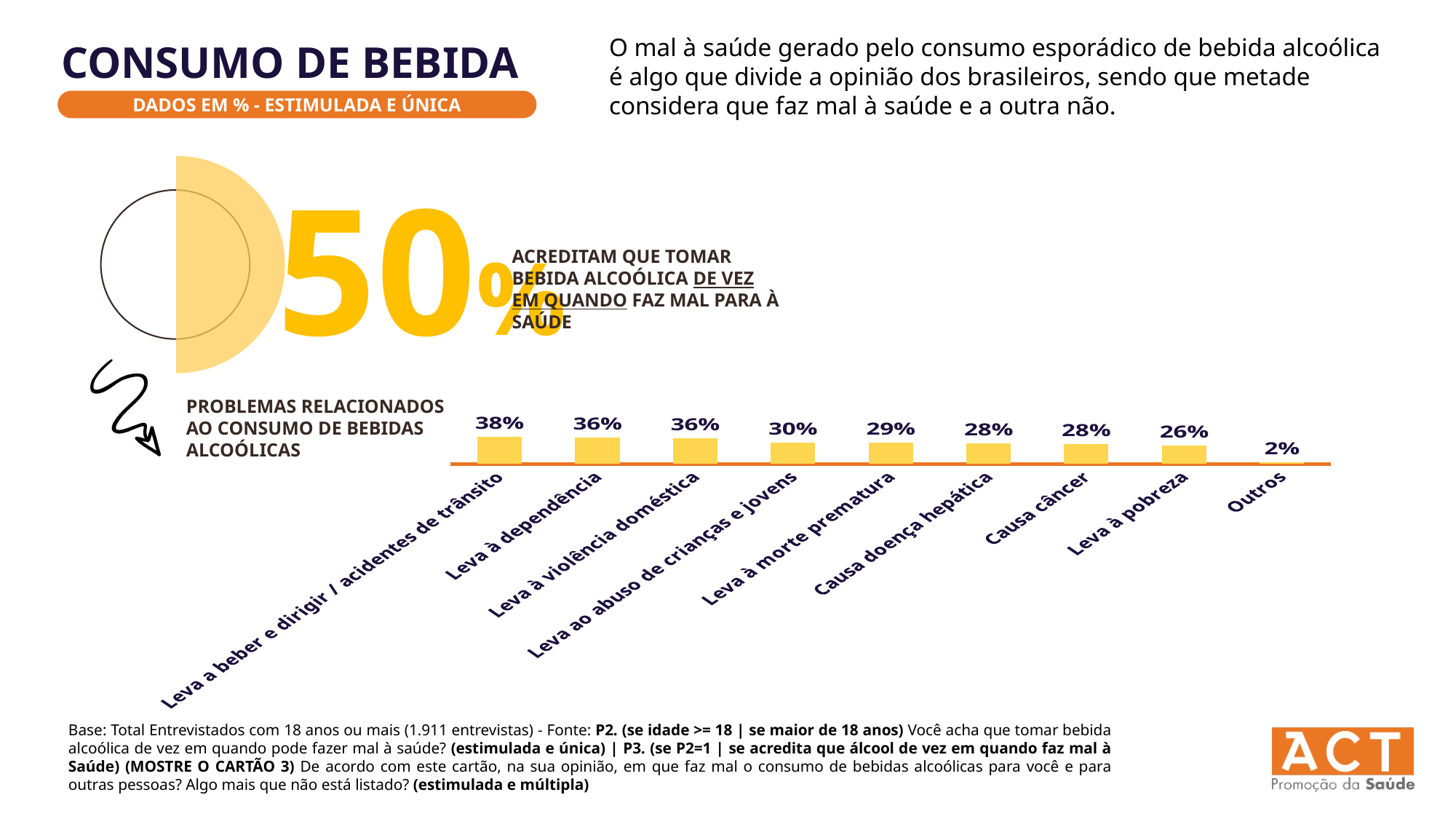
Which is larger: the value for "Leva à dependência" or the value for "Causa câncer"? Leva à dependência What is the difference between the values for "Leva ao abuso de crianças e jovens" and "Outros"? 28% Which category has the highest value in the bar chart? Leva a beber e dirigir / acidentes de trânsito What is the value for "Leva a beber e dirigir / acidentes de trânsito" in the bar chart? 38% How many categories are shown in the bar chart? 9 What is the value for "Leva à morte prematura" in the bar chart? 29% What kind of chart is used to show the problems related to alcohol consumption? Bar chart What is the value for "Outros" in the bar chart? 2% What is the difference between the values for "Leva a beber e dirigir / acidentes de trânsito" and "Leva à pobreza"? 12% Which category has the lowest value in the bar chart? Outros Do the values in the bar chart rise or fall from left to right? Fall What is the value for "Leva à pobreza" in the bar chart? 26%